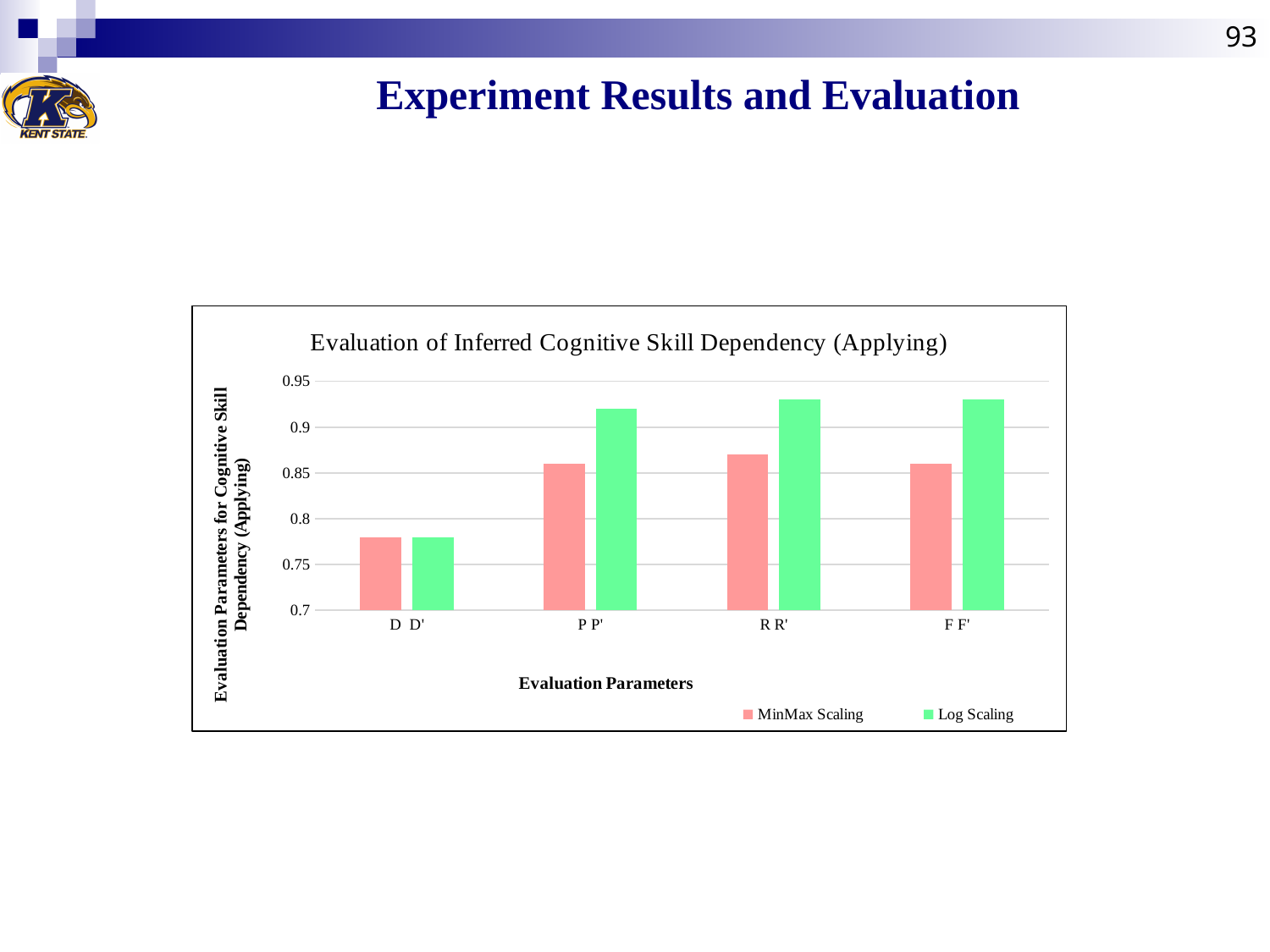
Is the MinMax Scaling value for D D' greater or less than 0.8? less For P P', which series has the larger value, MinMax Scaling or Log Scaling? Log Scaling How many categories are shown on the x axis? 4 Is the Log Scaling value for D D' greater or less than 0.8? less Is the Log Scaling value for F F' greater or less than 0.9? greater Which category has the lowest MinMax Scaling value? D D' What kind of chart is shown on the slide? bar chart Which category has the lowest Log Scaling value? D D' What is the title of the chart? Evaluation of Inferred Cognitive Skill Dependency (Applying) How many series does the legend list? 2